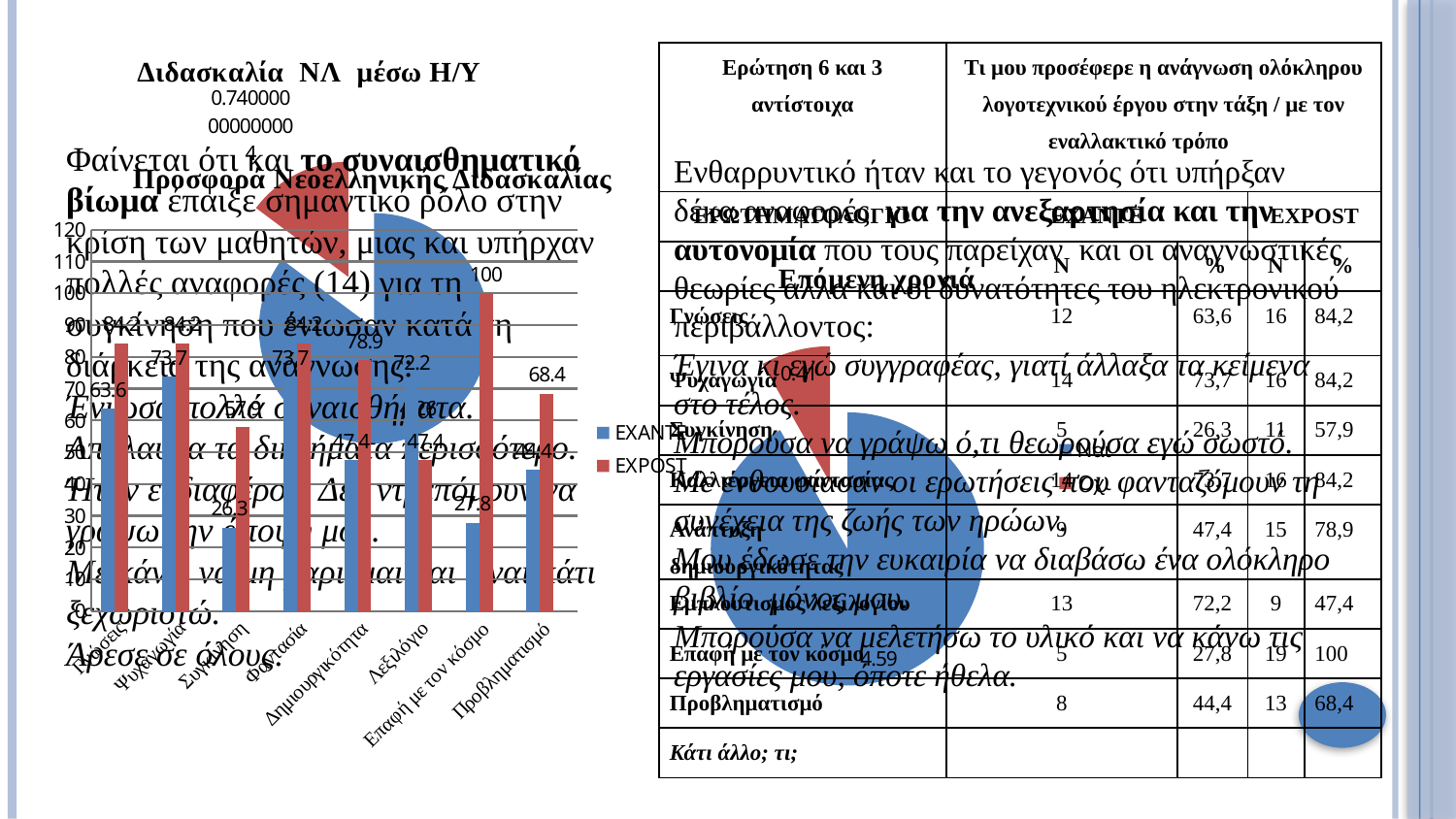
In the 'Προσφορά Νεοελληνικής Διδασκαλίας' chart, what is the EXANTE value for 'Ψυχαγωγία'? 73.7 How many series does the legend of the 'Προσφορά Νεοελληνικής Διδασκαλίας' chart list? 2 In the 'Προσφορά Νεοελληνικής Διδασκαλίας' chart, what is the EXANTE value for 'Επαφή με τον κόσμο'? 27.8 What is the highest value shown on the vertical axis of the 'Προσφορά Νεοελληνικής Διδασκαλίας' chart? 120 In the 'Προσφορά Νεοελληνικής Διδασκαλίας' chart, which category has the highest EXPOST value? Επαφή με τον κόσμο In the 'Προσφορά Νεοελληνικής Διδασκαλίας' chart, what is the difference between the EXPOST and EXANTE values for 'Επαφή με τον κόσμο'? 72.2 In the 'Προσφορά Νεοελληνικής Διδασκαλίας' chart, what is the EXPOST value for 'Επαφή με τον κόσμο'? 100 What type of chart is 'Προσφορά Νεοελληνικής Διδασκαλίας'? bar chart In the 'Προσφορά Νεοελληνικής Διδασκαλίας' chart, which is larger for 'Λεξιλόγιο': the EXANTE value or the EXPOST value? EXANTE What are the two series named in the legend of the 'Προσφορά Νεοελληνικής Διδασκαλίας' chart? EXANTE and EXPOST In the 'Προσφορά Νεοελληνικής Διδασκαλίας' chart, what is the EXPOST value for 'Προβληματισμό'? 68.4 In the 'Προσφορά Νεοελληνικής Διδασκαλίας' chart, is the EXANTE value for 'Συγκίνηση' greater or less than 30? less